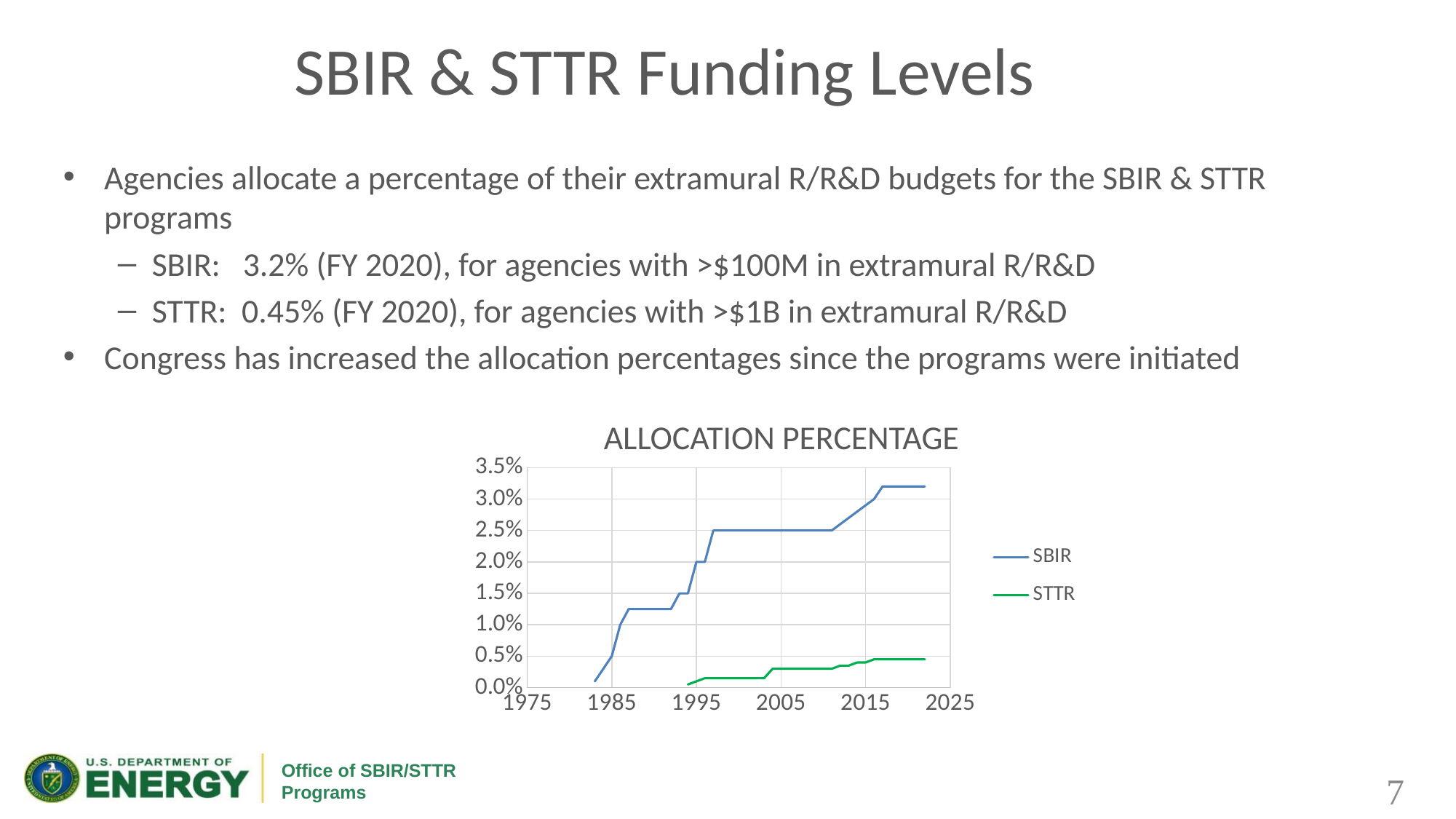
How many series does the chart legend list? 2 What is the SBIR allocation percentage in 2005? 2.5% Is the SBIR allocation percentage in 2020 greater or less than 3.0%? greater Does the STTR allocation percentage rise or fall from 1995 to 2020? rise Which series has the higher allocation percentage in 2015, SBIR or STTR? SBIR What kind of chart is shown on the slide? line chart Is the STTR allocation percentage in 2020 greater or less than 0.5%? less Does the SBIR allocation percentage generally rise or fall from 1985 to 2020? rise Is the SBIR allocation percentage in 1990 greater or less than 1.5%? less What is the title of the chart? ALLOCATION PERCENTAGE Which series is drawn in green in the chart? STTR